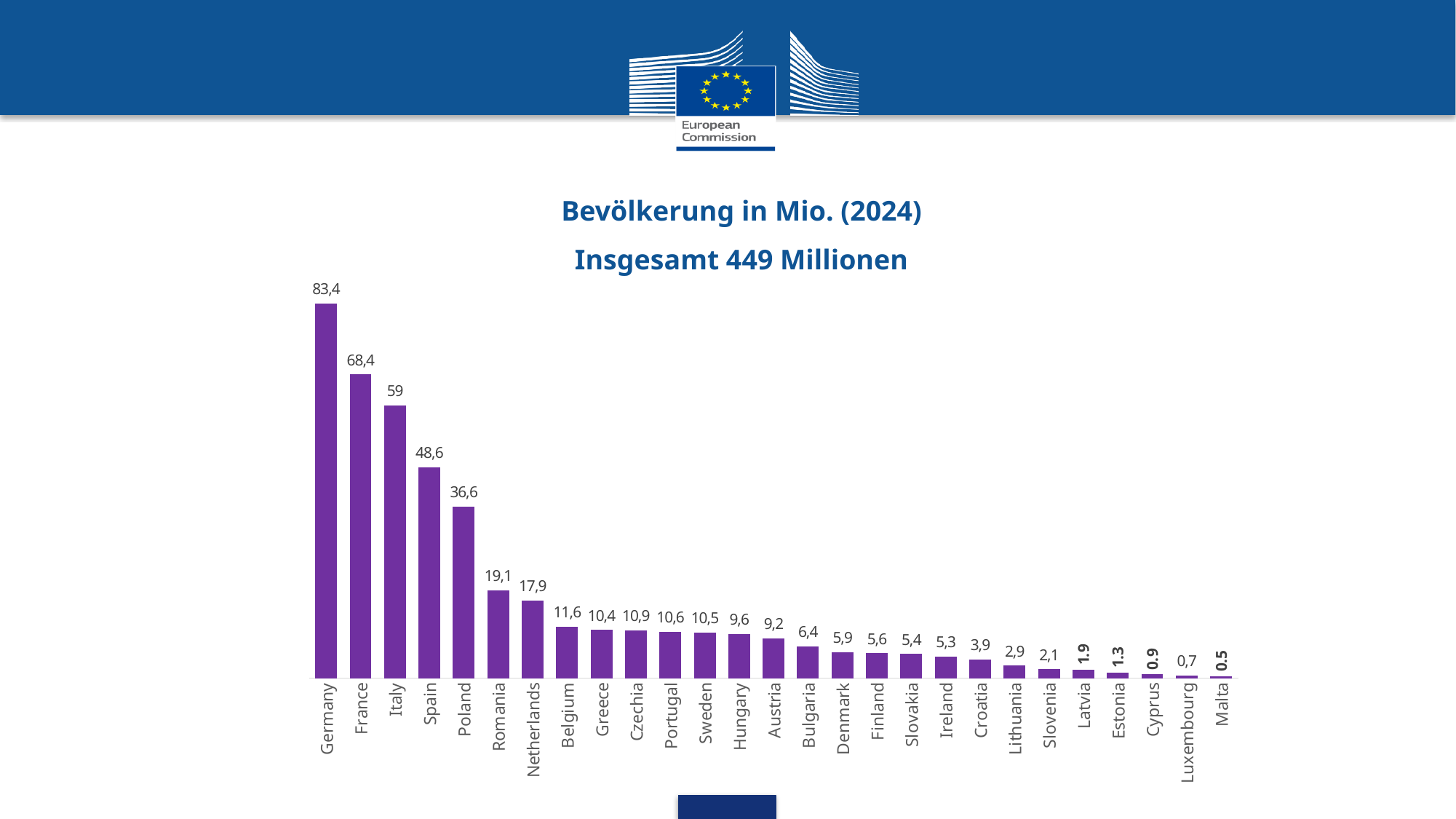
What is the difference between the values for Romania and the Netherlands? 1,2 What is the population value shown for Czechia? 10,9 What is the difference between the values for Italy and Spain? 10,4 What total population is stated in the chart title? 449 Millionen Which has a larger value, Belgium or Greece? Belgium What kind of chart is shown on the slide? Bar chart What is the population value shown for Germany? 83,4 What is the population value shown for Luxembourg? 0,7 Which country has the highest population in the chart? Germany What is the population value shown for Poland? 36,6 How many countries are shown in the chart? 27 Which country has the lowest population in the chart? Malta